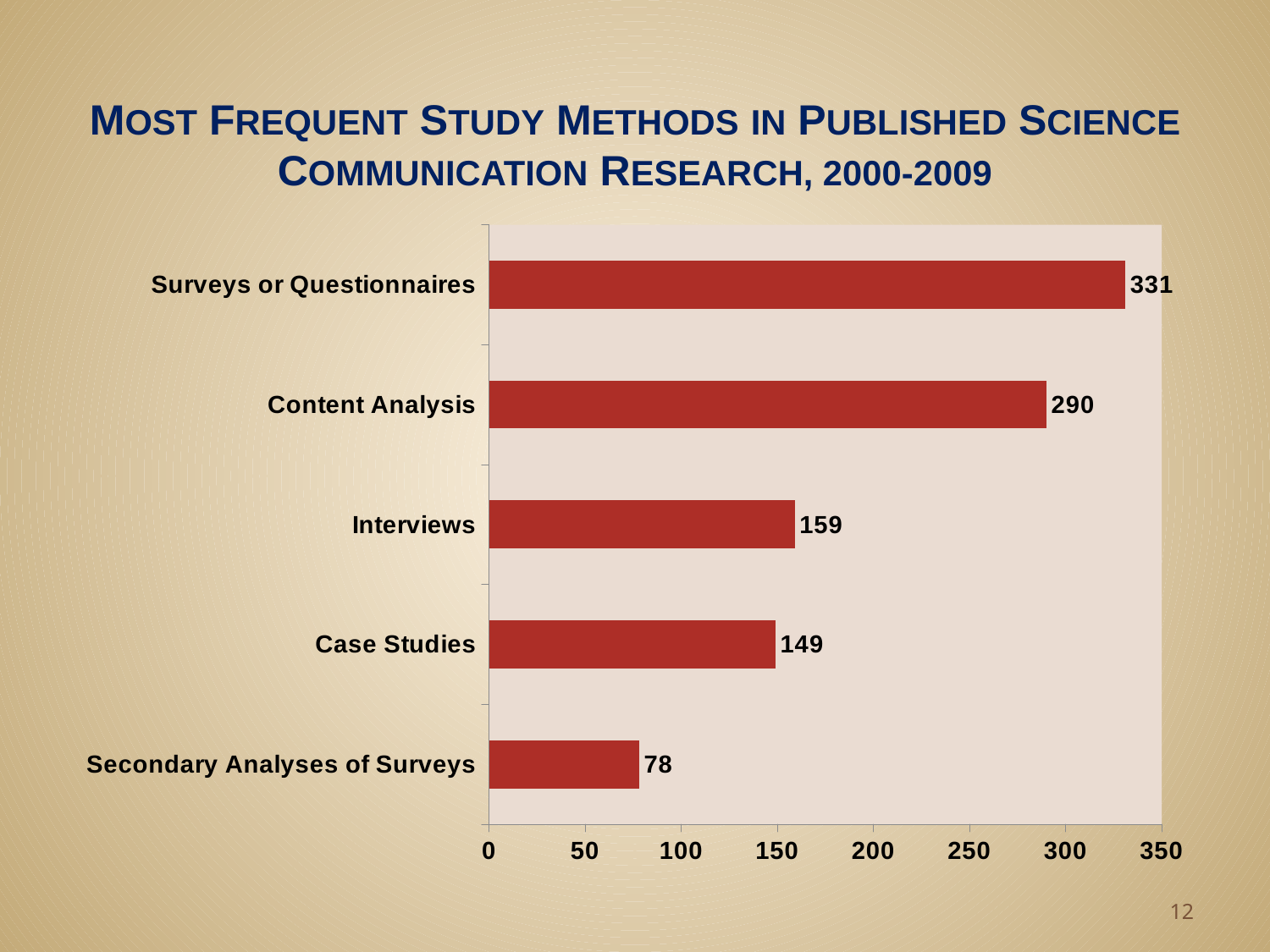
What kind of chart is shown on the slide? Bar chart What is the difference between the values for Interviews and Case Studies? 10 What is the value for Interviews? 159 How many study methods are shown in the chart? 5 Is the value for Case Studies greater or less than 100? greater What is the value for Content Analysis? 290 Which study method has the lowest value? Secondary Analyses of Surveys Which is larger, the value for Content Analysis or the value for Interviews? Content Analysis Which study method has the highest value? Surveys or Questionnaires What is the value for Secondary Analyses of Surveys? 78 What is the value for Surveys or Questionnaires? 331 What is the difference between the values for Surveys or Questionnaires and Content Analysis? 41